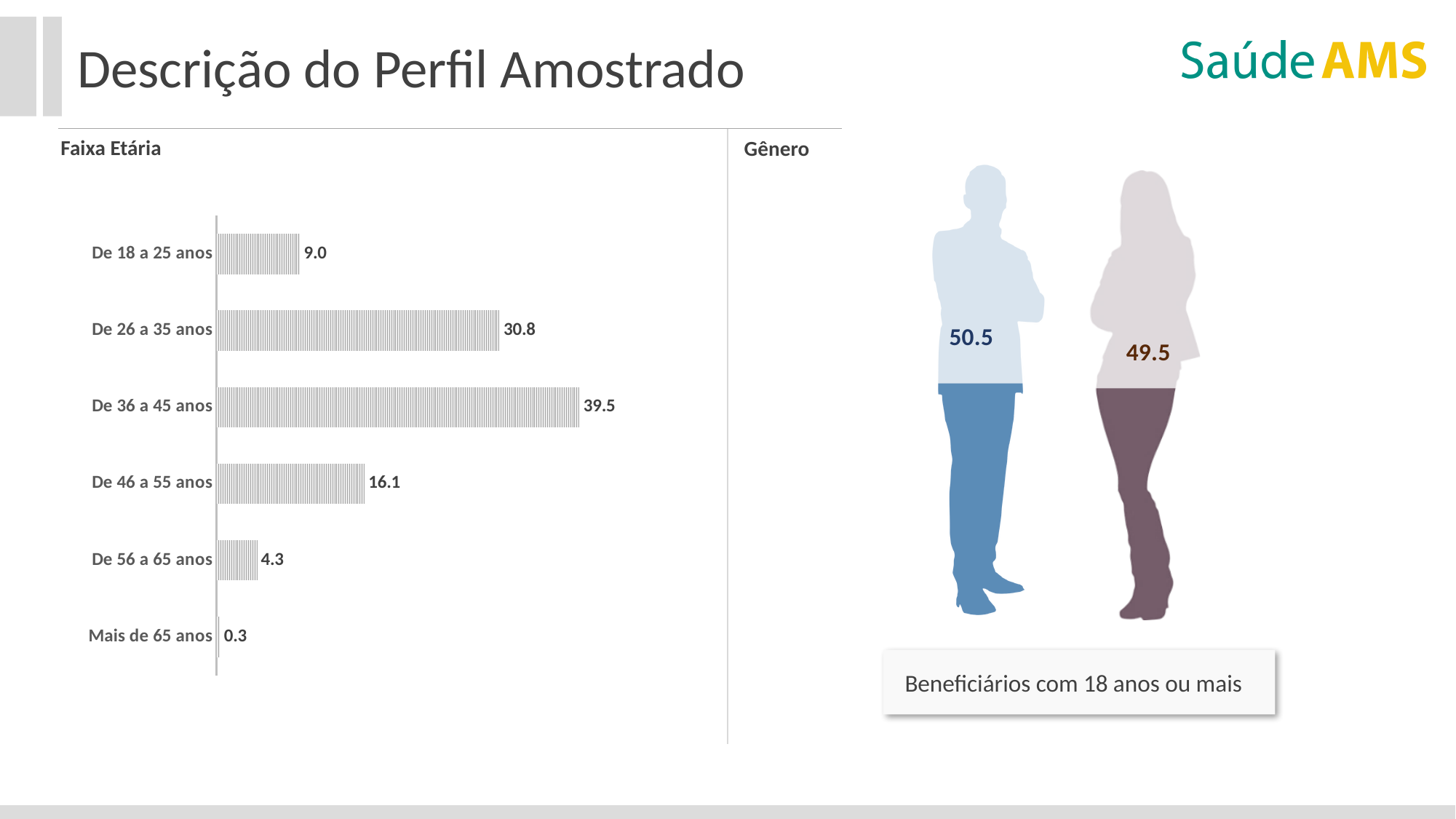
In the Faixa Etária chart, what is the value for De 36 a 45 anos? 39.5 In the Faixa Etária chart, which age group has the lowest value? Mais de 65 anos In the Faixa Etária chart, what is the difference between De 36 a 45 anos and De 26 a 35 anos? 8.7 In the Faixa Etária chart, which is larger: De 46 a 55 anos or De 18 a 25 anos? De 46 a 55 anos In the Faixa Etária chart, what is the value for De 18 a 25 anos? 9.0 In the Gênero section, what is the value shown on the male figure? 50.5 In the Gênero section, what is the value shown on the female figure? 49.5 In the Gênero section, what is the difference between the male and female values? 1.0 In the Faixa Etária chart, what is the value for Mais de 65 anos? 0.3 What kind of chart is the Faixa Etária chart? Bar chart In the Faixa Etária chart, which age group has the highest value? De 36 a 45 anos How many age groups are shown in the Faixa Etária chart? 6